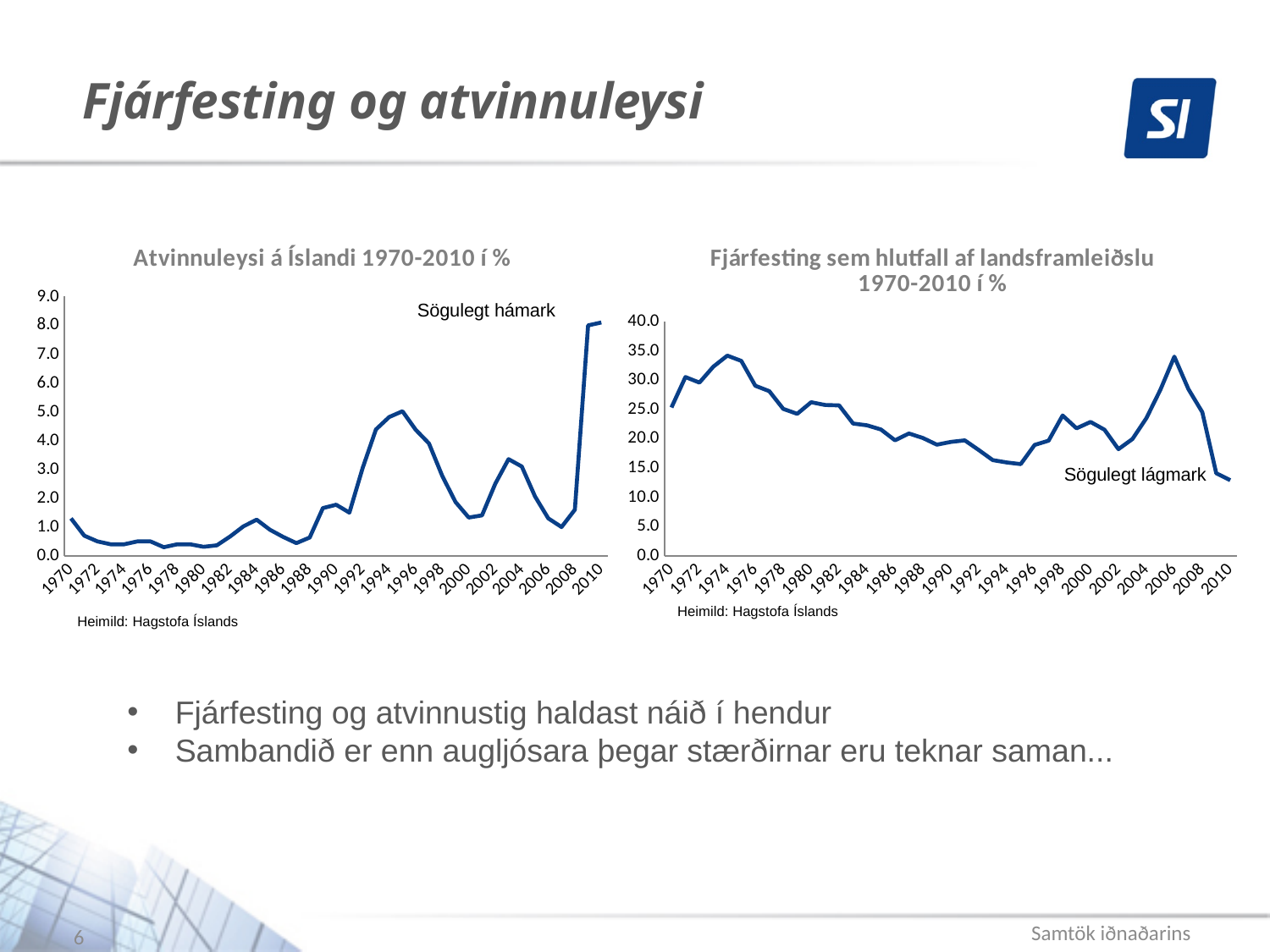
In the left chart 'Atvinnuleysi á Íslandi 1970-2010 í %', is the value for 2010 greater or less than 7.0? greater In the right chart 'Fjárfesting sem hlutfall af landsframleiðslu 1970-2010 í %', do the values rise or fall from 2006 to 2010? fall In the right chart 'Fjárfesting sem hlutfall af landsframleiðslu 1970-2010 í %', is the value for 2010 greater or less than 15.0? less What kind of chart is the right chart titled 'Fjárfesting sem hlutfall af landsframleiðslu 1970-2010 í %'? Line chart In the left chart 'Atvinnuleysi á Íslandi 1970-2010 í %', which is larger, the value for 1994 or the value for 2003? 1994 What kind of chart is the left chart titled 'Atvinnuleysi á Íslandi 1970-2010 í %'? Line chart What annotation is placed next to the peak in the left chart 'Atvinnuleysi á Íslandi 1970-2010 í %'? Sögulegt hámark In the right chart 'Fjárfesting sem hlutfall af landsframleiðslu 1970-2010 í %', is the value for 2006 greater or less than 30.0? greater In the left chart 'Atvinnuleysi á Íslandi 1970-2010 í %', which year has the highest value? 2010 In the right chart 'Fjárfesting sem hlutfall af landsframleiðslu 1970-2010 í %', which is larger, the value for 2006 or the value for 1998? 2006 In the right chart 'Fjárfesting sem hlutfall af landsframleiðslu 1970-2010 í %', which year has the lowest value? 2010